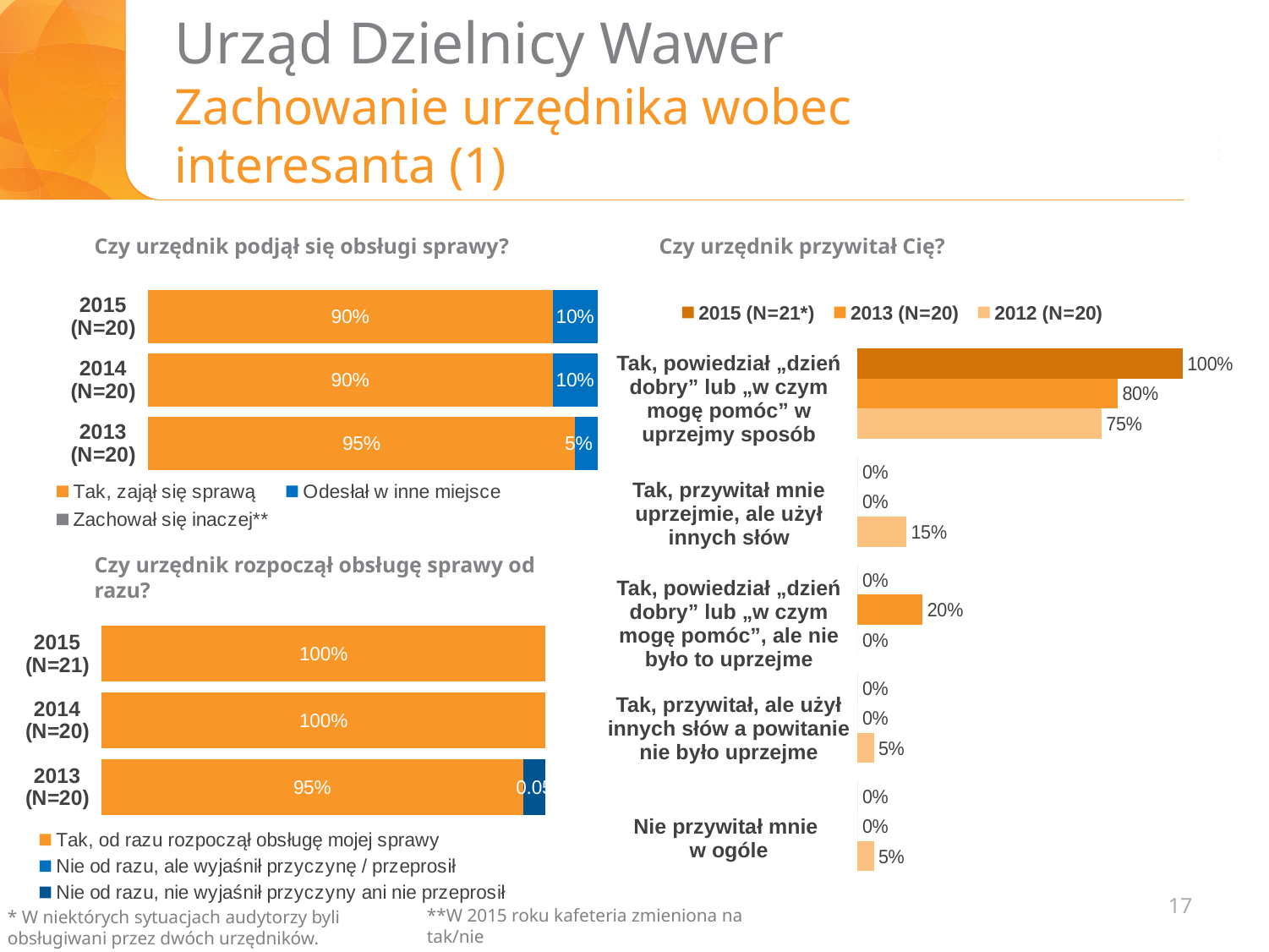
In the chart "Czy urzędnik podjął się obsługi sprawy?", what is the value for "Tak, zajął się sprawą" in 2013 (N=20)? 95% In the chart "Czy urzędnik podjął się obsługi sprawy?", what is the difference between the "Tak, zajął się sprawą" values for 2013 (N=20) and 2014 (N=20)? 5% In the chart "Czy urzędnik przywitał Cię?", what is the difference between the 2015 (N=21*) and 2012 (N=20) values in the category "Tak, powiedział „dzień dobry” lub „w czym mogę pomóc” w uprzejmy sposób"? 25% In the chart "Czy urzędnik przywitał Cię?", what is the value for 2013 (N=20) in the category "Tak, powiedział „dzień dobry” lub „w czym mogę pomóc” w uprzejmy sposób"? 80% In the chart "Czy urzędnik rozpoczął obsługę sprawy od razu?", what is the value for "Tak, od razu rozpoczął obsługę mojej sprawy" in 2013 (N=20)? 95% In the chart "Czy urzędnik przywitał Cię?", what is the value for 2012 (N=20) in the category "Tak, przywitał mnie uprzejmie, ale użył innych słów"? 15% In the chart "Czy urzędnik podjął się obsługi sprawy?", how many series does the legend list? 3 What type of chart is "Czy urzędnik rozpoczął obsługę sprawy od razu?"? Stacked bar chart In the chart "Czy urzędnik przywitał Cię?", how many categories are shown on the vertical axis? 5 In the chart "Czy urzędnik podjął się obsługi sprawy?", what is the value for "Odesłał w inne miejsce" in 2015 (N=20)? 10% In the chart "Czy urzędnik rozpoczął obsługę sprawy od razu?", how many year categories are shown? 3 In the chart "Czy urzędnik przywitał Cię?", which year has the highest value in the category "Tak, powiedział „dzień dobry” lub „w czym mogę pomóc” w uprzejmy sposób"? 2015 (N=21*)